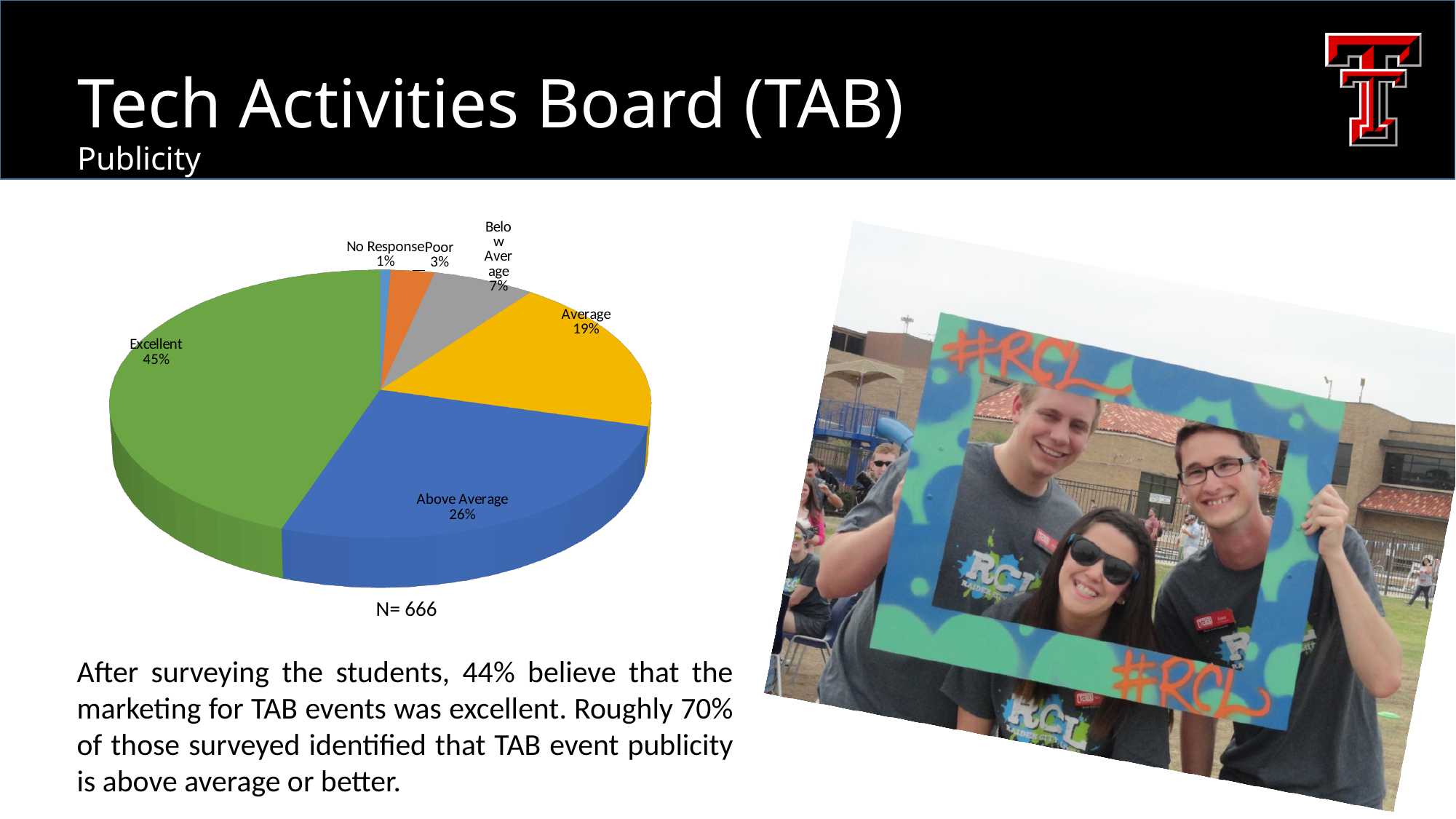
What percentage of respondents rated TAB publicity as Below Average? 7% What percentage of respondents rated TAB publicity as Excellent? 45% Which category has the smallest share of the pie? No Response Which is larger, the Average slice or the Below Average slice? Average What percentage of respondents rated TAB publicity as Average? 19% What kind of chart is shown on the slide? pie chart What percentage of respondents rated TAB publicity as Poor? 3% What percentage of respondents gave No Response? 1% What percentage of respondents rated TAB publicity as Above Average? 26% How many categories are shown in the pie chart? 6 Which category has the largest share of the pie? Excellent What is the difference in percentage points between the Excellent and Above Average slices? 19